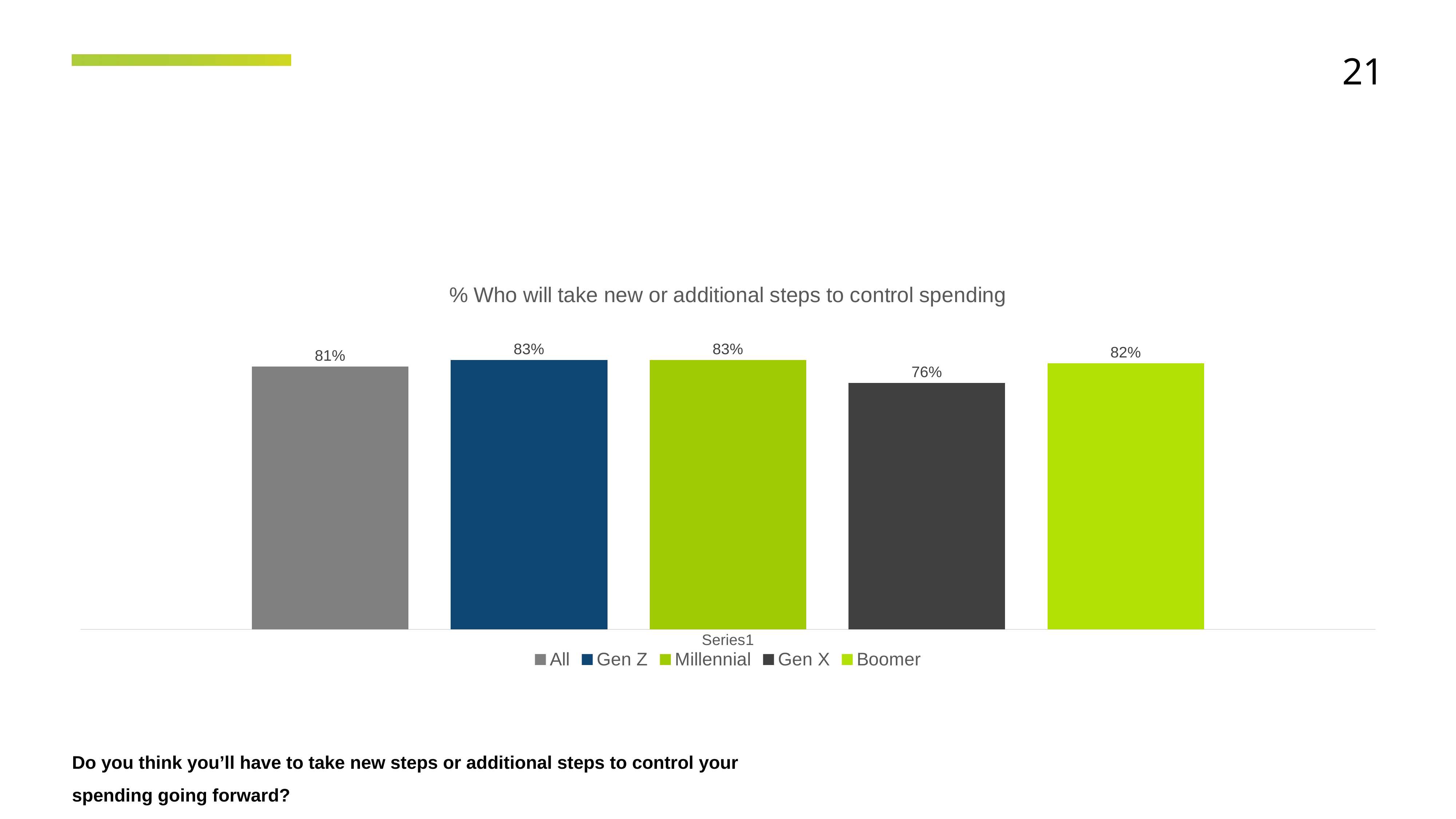
Which group has the lowest value? Gen X What is the difference between the values for Boomer and All? 1 percentage point What is the value for Gen X? 76% What is the difference between the values for Gen Z and Gen X? 7 percentage points Which is larger, the value for Boomer or the value for Gen X? Boomer How many entries does the legend list? 5 What is the value for All? 81% What is the value for Millennial? 83% What is the value for Boomer? 82% What is the value for Gen Z? 83% What kind of chart is shown on the slide? Bar chart How many bars are plotted on the chart? 5